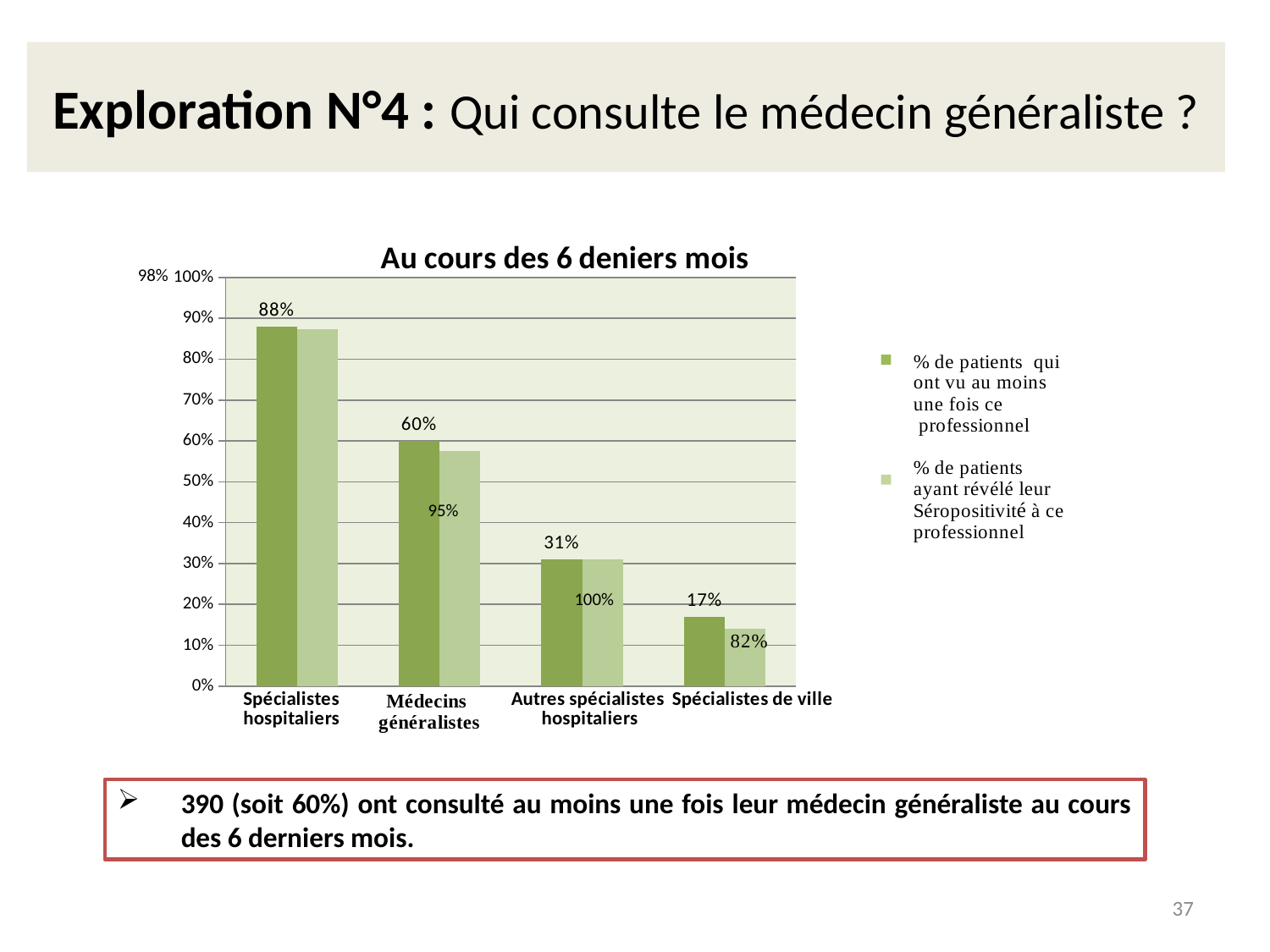
How many categories are shown on the x axis of the chart? 4 What is the value for Spécialistes hospitaliers in the series '% de patients qui ont vu au moins une fois ce professionnel'? 88% In the series '% de patients qui ont vu au moins une fois ce professionnel', which is larger: Médecins généralistes or Autres spécialistes hospitaliers? Médecins généralistes What is the value for Autres spécialistes hospitaliers in the series '% de patients qui ont vu au moins une fois ce professionnel'? 31% Is the value for Spécialistes de ville in the series '% de patients ayant révélé leur Séropositivité à ce professionnel' greater or less than 20%? less What is the difference between Spécialistes hospitaliers (88%) and Médecins généralistes (60%) in the series '% de patients qui ont vu au moins une fois ce professionnel'? 28 percentage points Which category has the lowest value for '% de patients qui ont vu au moins une fois ce professionnel'? Spécialistes de ville What kind of chart is shown on the slide? Bar chart What is the value for Spécialistes de ville in the series '% de patients qui ont vu au moins une fois ce professionnel'? 17% How many series does the legend list? 2 What is the value for Médecins généralistes in the series '% de patients qui ont vu au moins une fois ce professionnel'? 60% Which category has the highest value for '% de patients qui ont vu au moins une fois ce professionnel'? Spécialistes hospitaliers